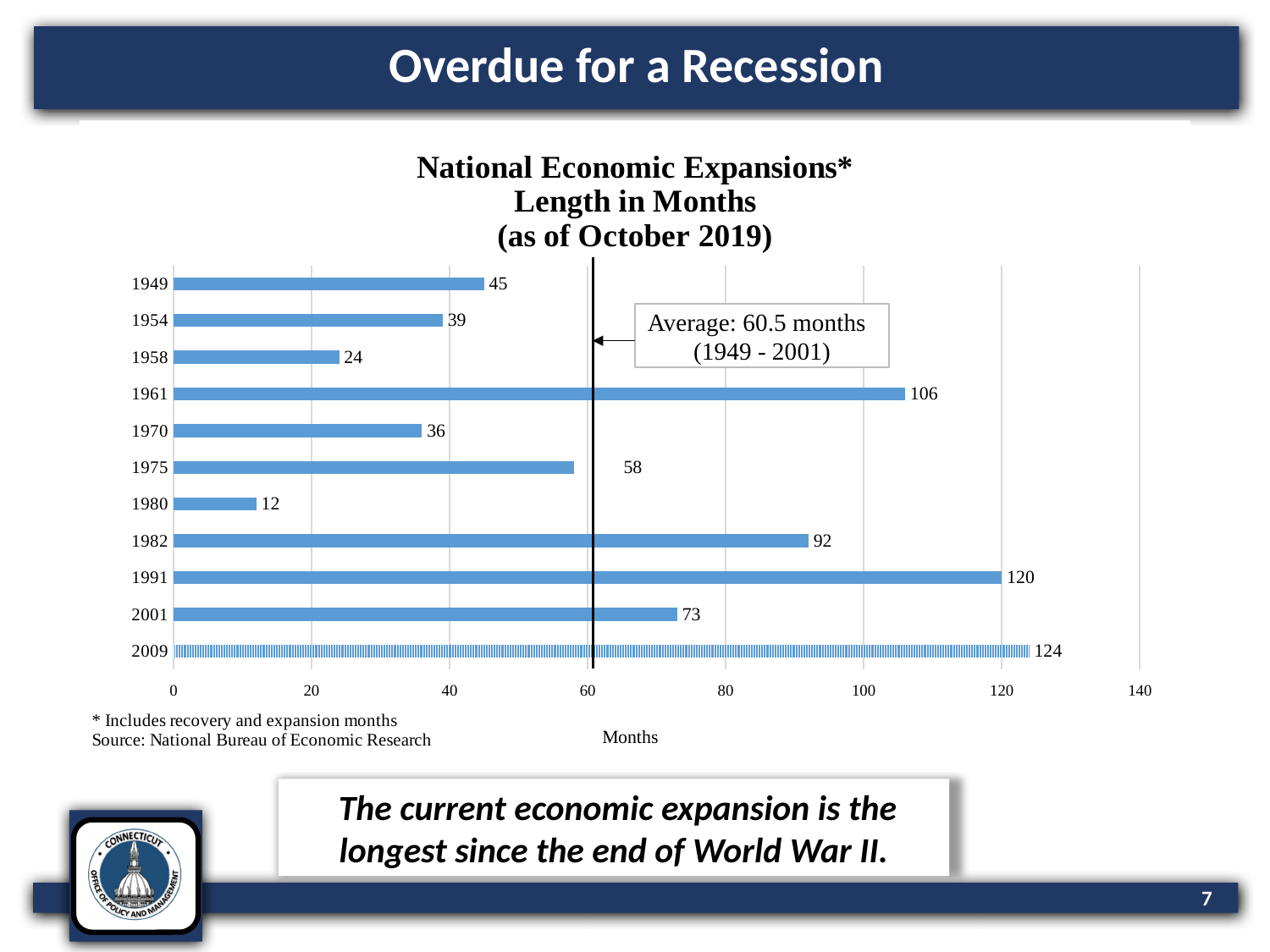
What kind of chart is shown on the slide? bar chart Which expansion was longer, the one starting in 1982 or the one starting in 1975? 1982 How many expansion start years are shown on the chart? 11 How many months long is the expansion that began in 2009? 124 Is the value for the 1954 expansion greater or less than 40? less Which expansion start year has the longest bar? 2009 What average value is marked by the vertical line on the chart? 60.5 months What is the length in months of the expansion that began in 1961? 106 What is the label on the horizontal axis of the chart? Months How many months longer is the 1991 expansion than the 2001 expansion? 47 Which expansion start year has the shortest bar? 1980 What is the value shown for the 1980 expansion? 12